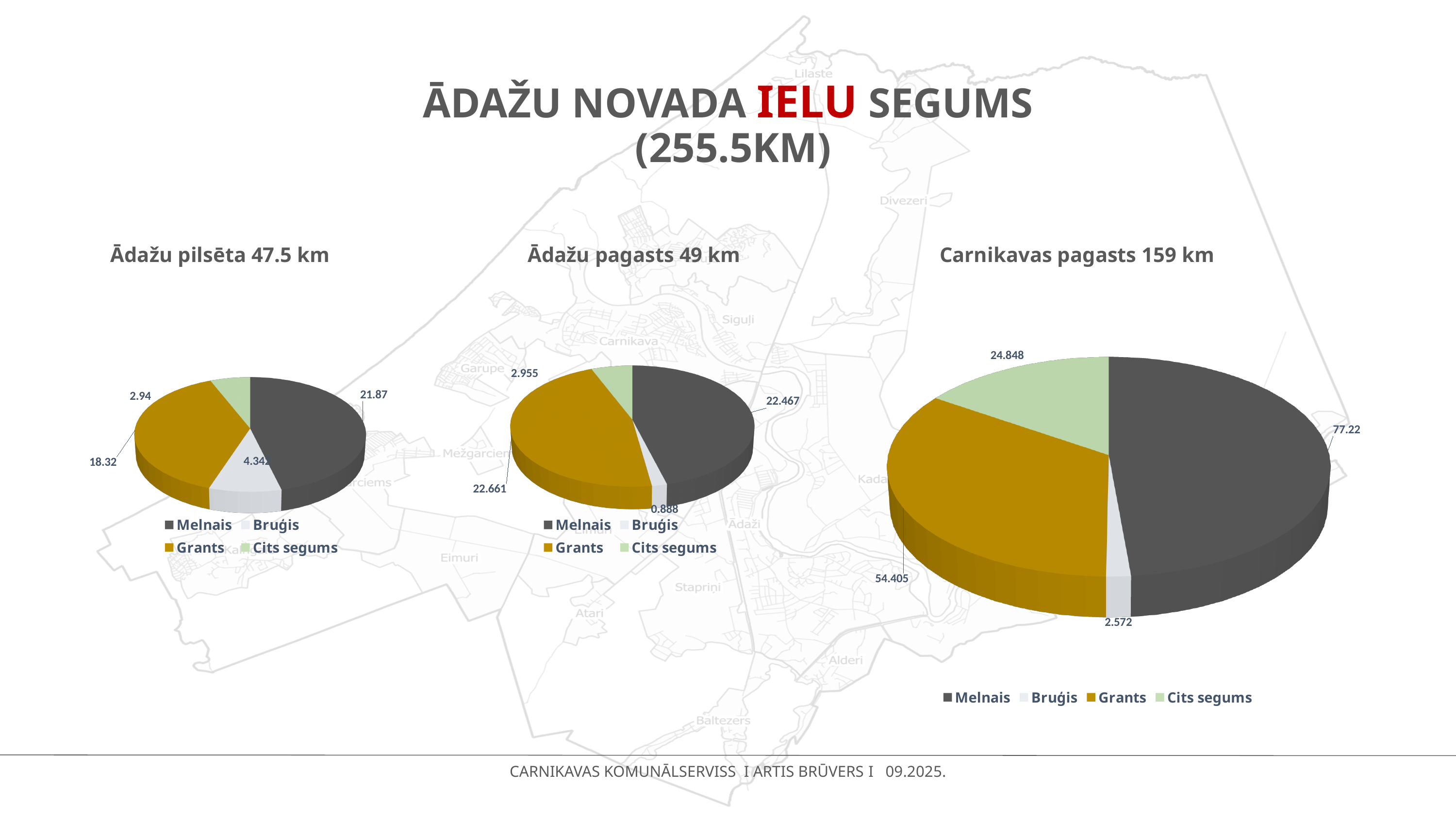
In the Carnikavas pagasts 159 km chart, which category has the largest slice? Melnais In the Ādažu pilsēta 47.5 km chart, what is the difference between the Melnais and Grants values? 3.55 In the Carnikavas pagasts 159 km chart, what is the difference between the Melnais and Grants values? 22.815 How many categories does the Ādažu pilsēta 47.5 km chart show? 4 In the Carnikavas pagasts 159 km chart, what is the value for Cits segums? 24.848 What kind of chart is the Carnikavas pagasts 159 km chart? Pie chart In the Ādažu pagasts 49 km chart, which category has the smallest slice? Bruģis In the Ādažu pilsēta 47.5 km chart, what is the value for Bruģis? 4.342 In the Carnikavas pagasts 159 km chart, which is larger, Melnais or Grants? Melnais In the Ādažu pilsēta 47.5 km chart, what is the value for Melnais? 21.87 In the Ādažu pagasts 49 km chart, what is the value for Grants? 22.661 In the Ādažu pagasts 49 km chart, what is the value for Cits segums? 2.955